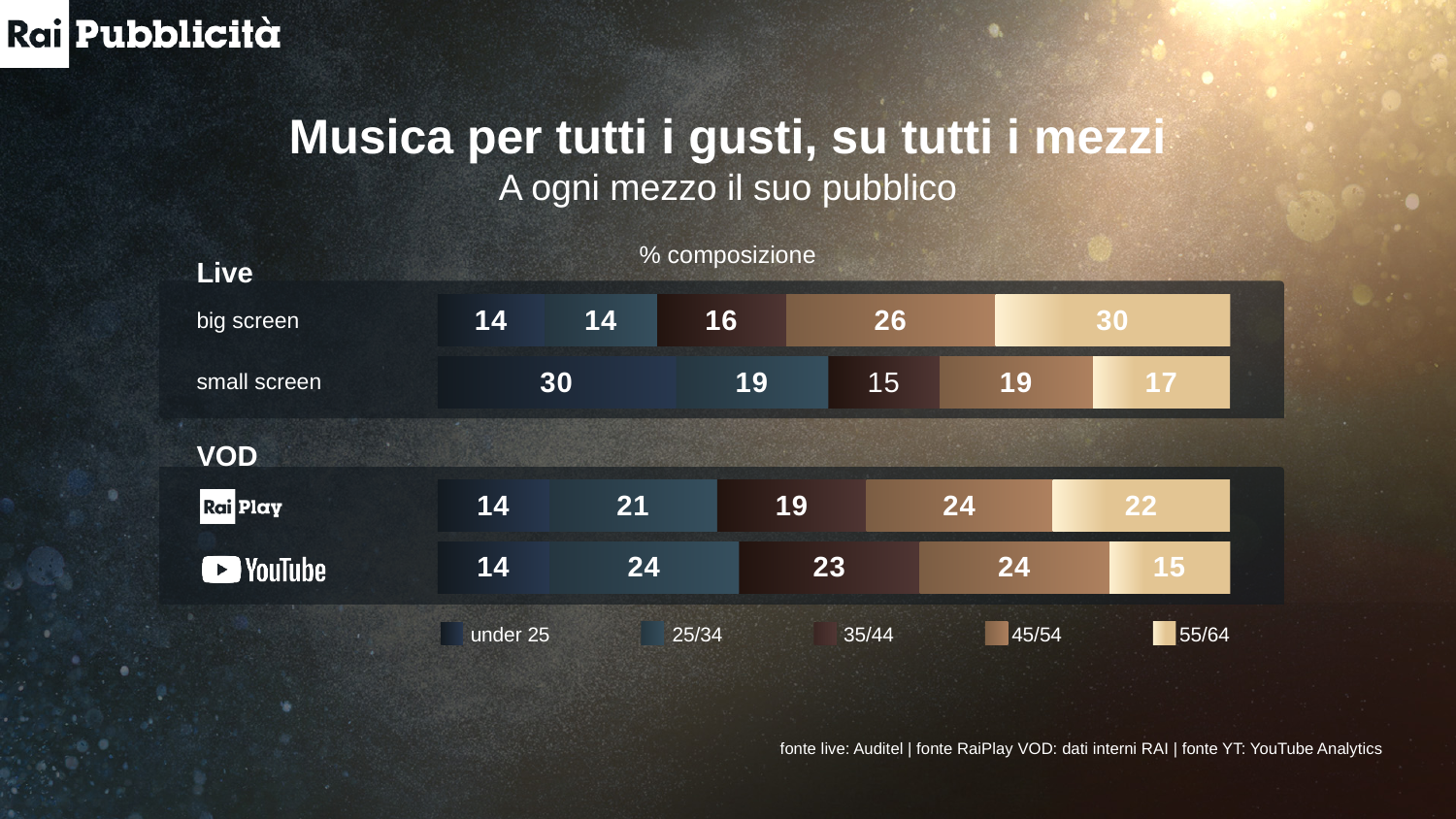
Which is larger: the 25/34 segment for YouTube or the 25/34 segment for RaiPlay? YouTube What is the value for the 45/54 segment of the RaiPlay bar? 24 Which age group has the smallest segment in the small screen bar? 35/44 What is the value for the 55/64 segment of the big screen bar? 30 How many bars (rows) does the chart show? 4 What is the difference between the 55/64 segment of the big screen bar and the 55/64 segment of the small screen bar? 13 What kind of chart is shown on the slide? Stacked bar chart Which age group has the largest segment in the big screen bar? 55/64 What is the total of the YouTube bar? 100 How many age groups does the legend list? 5 What is the value for the 35/44 segment of the YouTube bar? 23 What is the value for the under 25 segment of the small screen bar? 30